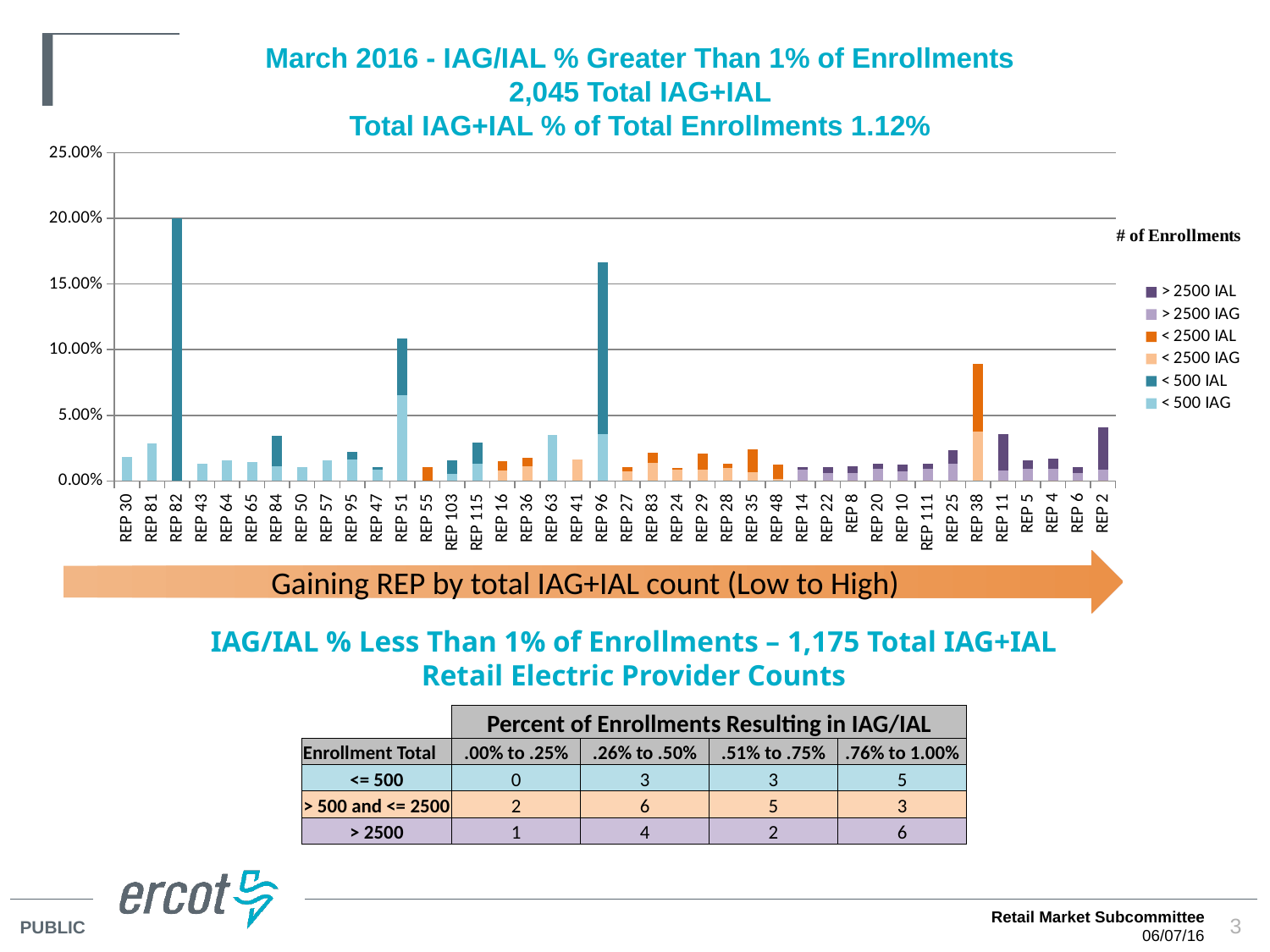
What is the total IAG+IAL count stated in the chart title? 2,045 Is the value for REP 38 greater or less than 10.00%? less How many series does the chart legend list? 6 Is the value for REP 82 greater or less than 15.00%? greater What kind of chart is shown on the slide? bar chart Is the value for REP 2 greater or less than 5.00%? less How many REP categories are plotted along the x axis of the chart? 40 What is the heading shown above the chart legend? # of Enrollments Which has the larger bar, REP 82 or REP 96? REP 82 Which has the larger bar, REP 51 or REP 38? REP 51 Which REP has the highest bar in the chart? REP 82